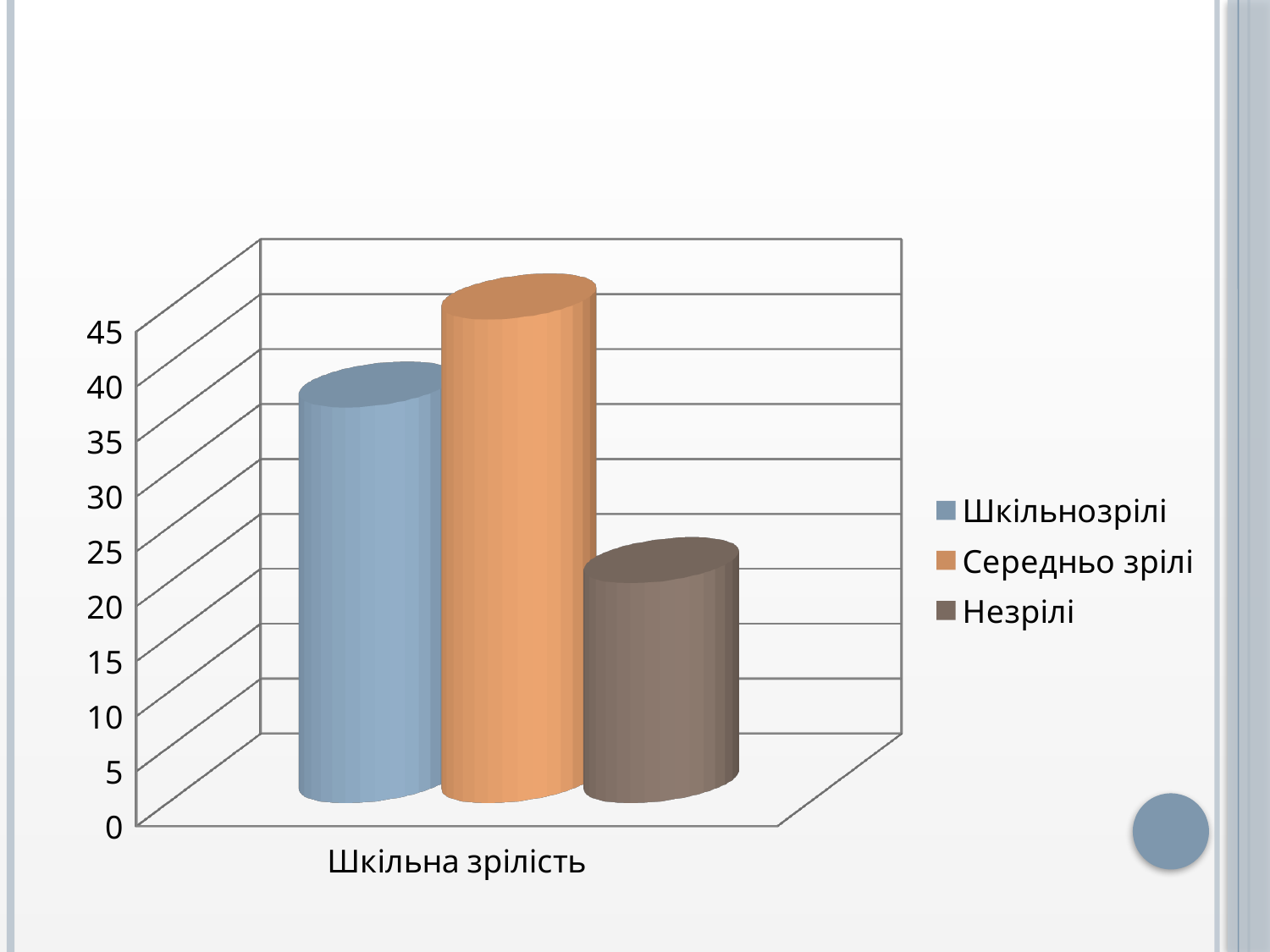
Which series has the lowest value? Незрілі What kind of chart is shown on the slide? bar chart Is the value for Середньо зрілі greater or less than 40? greater Is the value for Шкільнозрілі greater or less than 30? greater Which is larger, the value for Середньо зрілі or the value for Шкільнозрілі? Середньо зрілі Is the value for Незрілі greater or less than 30? less What colour is the bar for Середньо зрілі? orange Which is larger, the value for Шкільнозрілі or the value for Незрілі? Шкільнозрілі Which series has the highest value? Середньо зрілі What is the category label shown on the x axis? Шкільна зрілість How many series does the legend list? 3 How many categories are shown on the x axis? 1